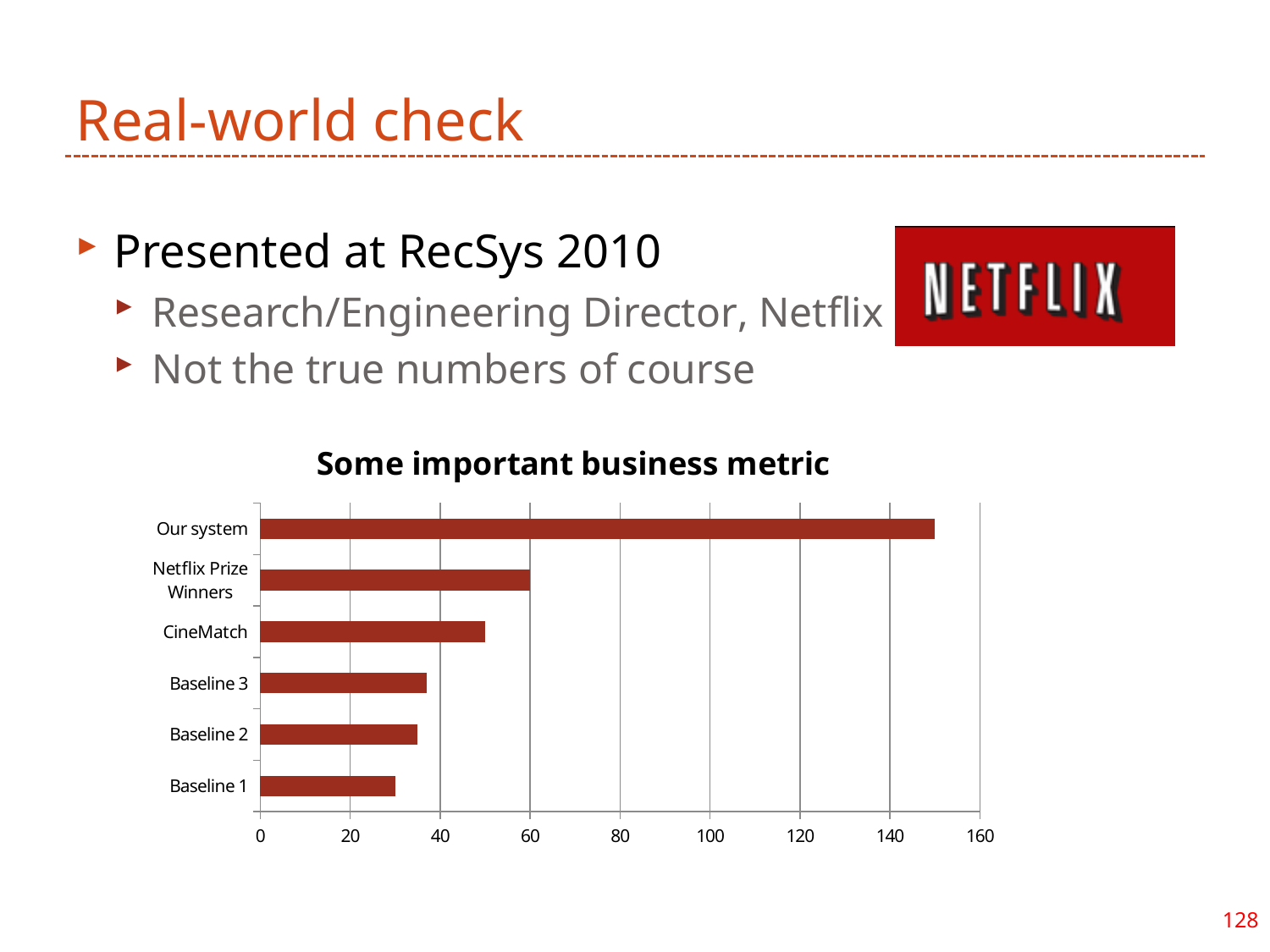
How many categories are shown in the chart? 6 Which category has the highest value? Our system What kind of chart is shown on the slide? bar chart What is the title of the chart? Some important business metric What is the value for Netflix Prize Winners? 60 Which category has the lowest value? Baseline 1 Which has a larger value, CineMatch or Baseline 2? CineMatch Is the value for Our system greater or less than 140? greater Is the value for Baseline 3 greater or less than 20? greater Which has a larger value, Our system or Netflix Prize Winners? Our system Is the value for Baseline 1 greater or less than 40? less